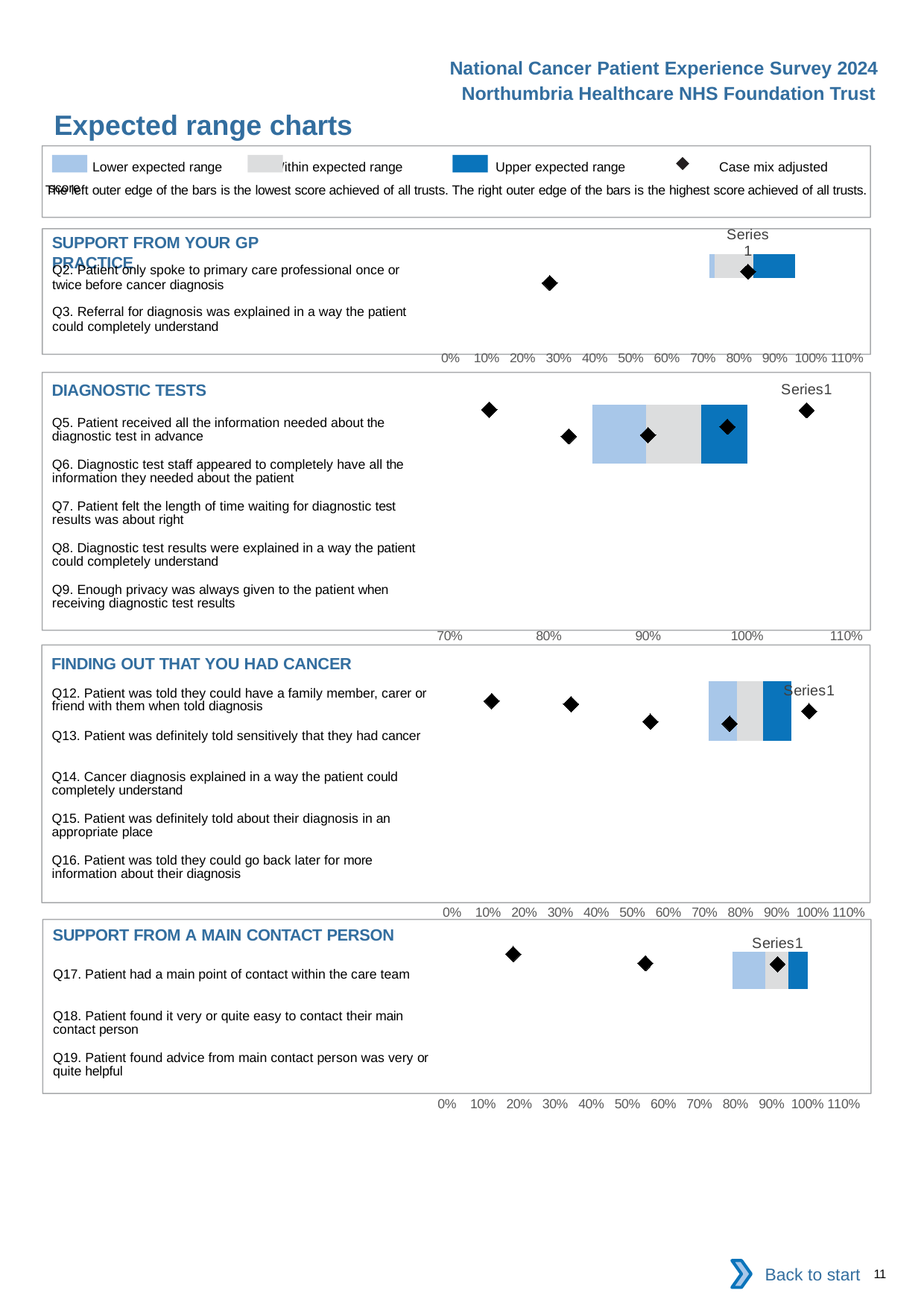
What is the title of the second chart from the top? DIAGNOSTIC TESTS How many entries does the legend at the top of the slide list? 4 In the FINDING OUT THAT YOU HAD CANCER chart, how many questions are listed? 5 In the SUPPORT FROM A MAIN CONTACT PERSON chart, is the lowest plotted case mix adjusted score marker greater or less than 30%? less In the SUPPORT FROM YOUR GP PRACTICE chart, how many questions are listed? 2 In the DIAGNOSTIC TESTS chart, how many questions are listed? 5 In the legend, which colour represents the upper expected range? Dark blue In the DIAGNOSTIC TESTS chart, what is the lowest value shown on the horizontal axis? 70% In the SUPPORT FROM A MAIN CONTACT PERSON chart, what is the highest value shown on the horizontal axis? 110%